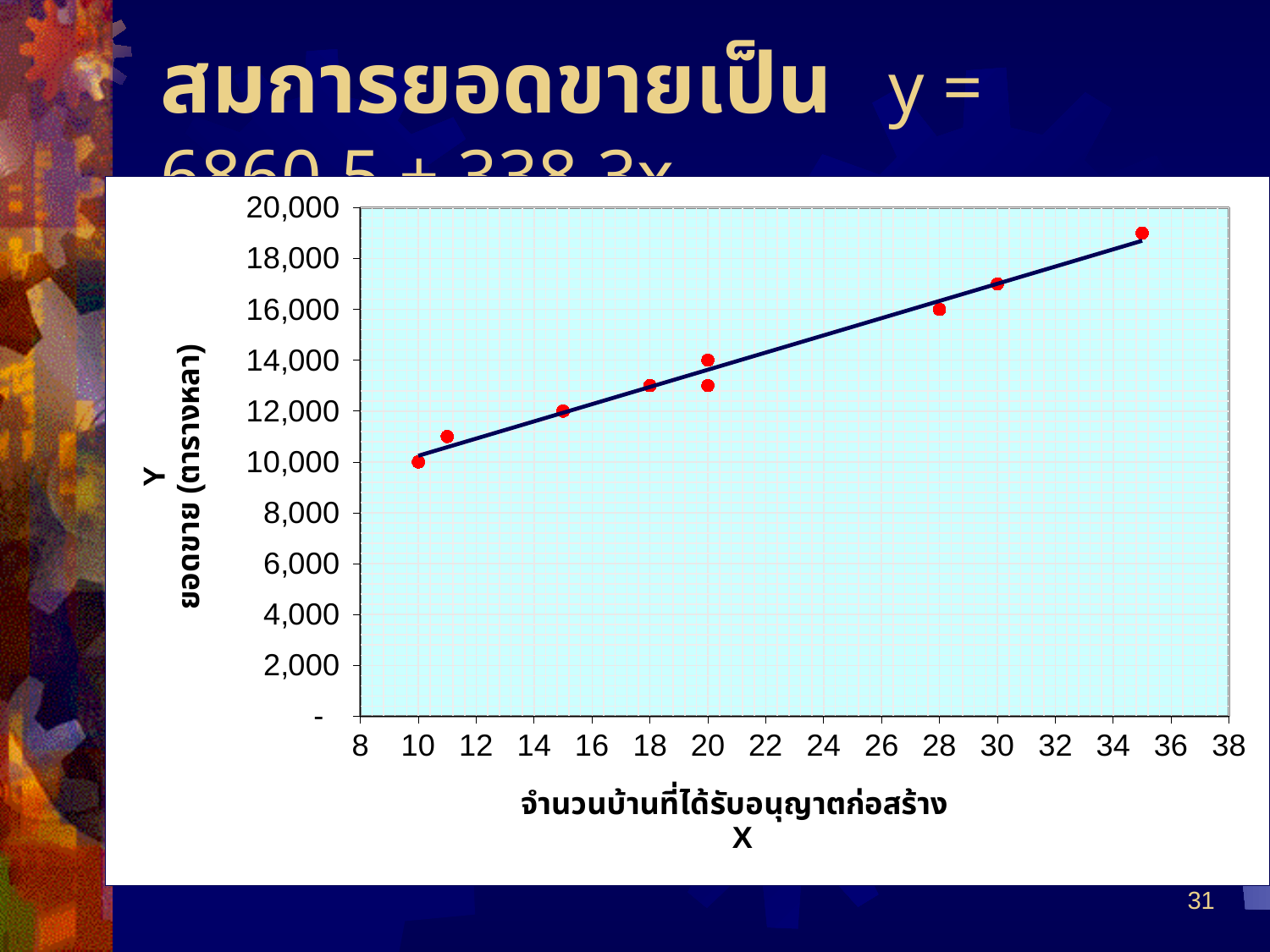
Is the Y value for the point at X = 35 greater or less than 18,000? greater What kind of chart is shown on the slide? Scatter chart with a trend line What is the Y value of the data point at X = 28? 16,000 What is the Y value of the data point at X = 10? 10,000 At which X value is the highest plotted Y value? 35 Do the plotted values rise or fall as X increases? Rise Is the Y value for the point at X = 30 greater or less than 16,000? greater How many data points are plotted on the chart? 9 What is the label of the X axis? จำนวนบ้านที่ได้รับอนุญาตก่อสร้าง X Is the Y value for the point at X = 11 greater or less than 12,000? less At which X value is the lowest plotted Y value? 10 Which has the larger Y value: the point at X = 28 or the point at X = 15? The point at X = 28